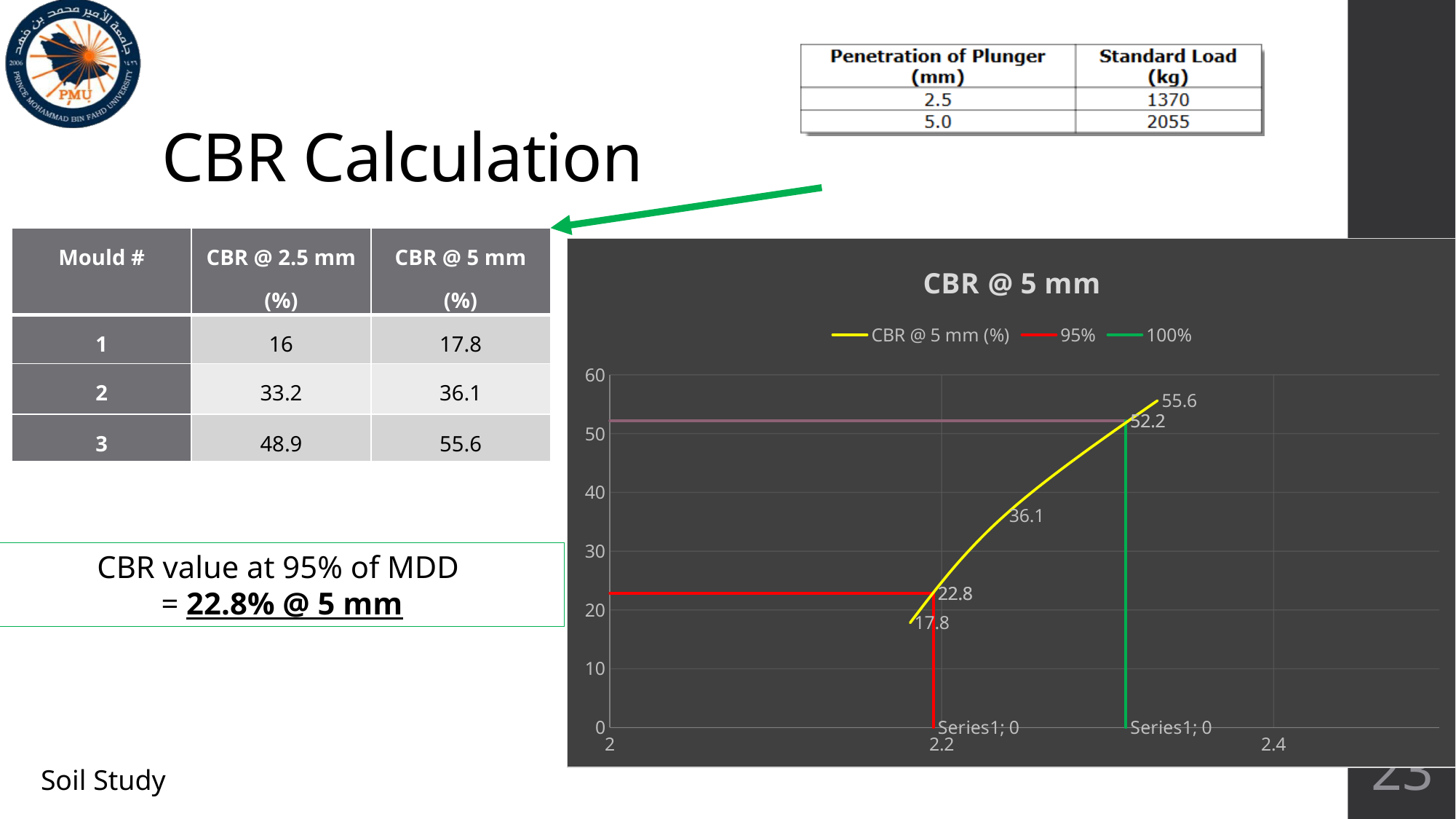
What is the highest data label shown on the CBR @ 5 mm (%) curve? 55.6 Does the CBR @ 5 mm (%) curve rise or fall as the x-axis value increases? rise Which labelled value on the curve is larger, 36.1 or 22.8? 36.1 What is the difference between the highest and lowest labelled values on the curve (55.6 and 17.8)? 37.8 What CBR value is labelled where the red 95% line meets the curve? 22.8 What is the lowest data label shown on the CBR @ 5 mm (%) curve? 17.8 How many series does the chart legend list? 3 What is the title of the chart? CBR @ 5 mm What CBR value is labelled where the green 100% line meets the curve? 52.2 What kind of chart is shown on the slide? line chart What is the difference between the labelled values 36.1 and 22.8 on the curve? 13.3